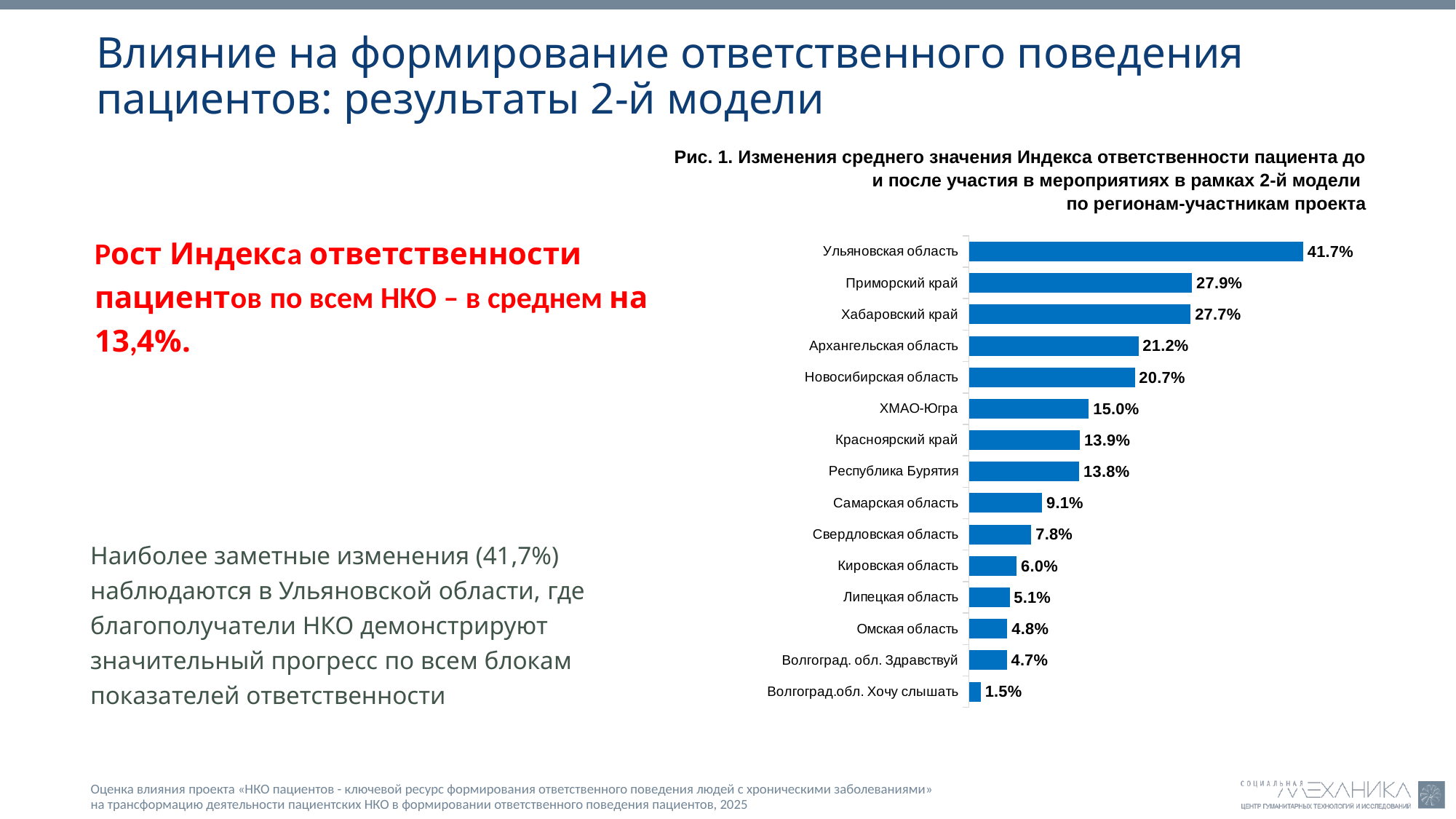
Which category has the lowest value in the chart? Волгоград.обл. Хочу слышать What is the value for Ульяновская область? 41.7% Which region has the highest value in the chart? Ульяновская область What is the difference between the values for ХМАО-Югра and Самарская область? 5.9% What is the value for Волгоград. обл. Здравствуй? 4.7% What is the value for Кировская область? 6.0% What is the difference between the values for Ульяновская область and Приморский край? 13.8% What type of chart is shown on the slide? Bar chart Which has a larger value, Самарская область or Свердловская область? Самарская область Do the bar values increase or decrease from the top of the chart to the bottom? Decrease What is the value for Новосибирская область? 20.7% How many regions (categories) are shown in the chart? 15